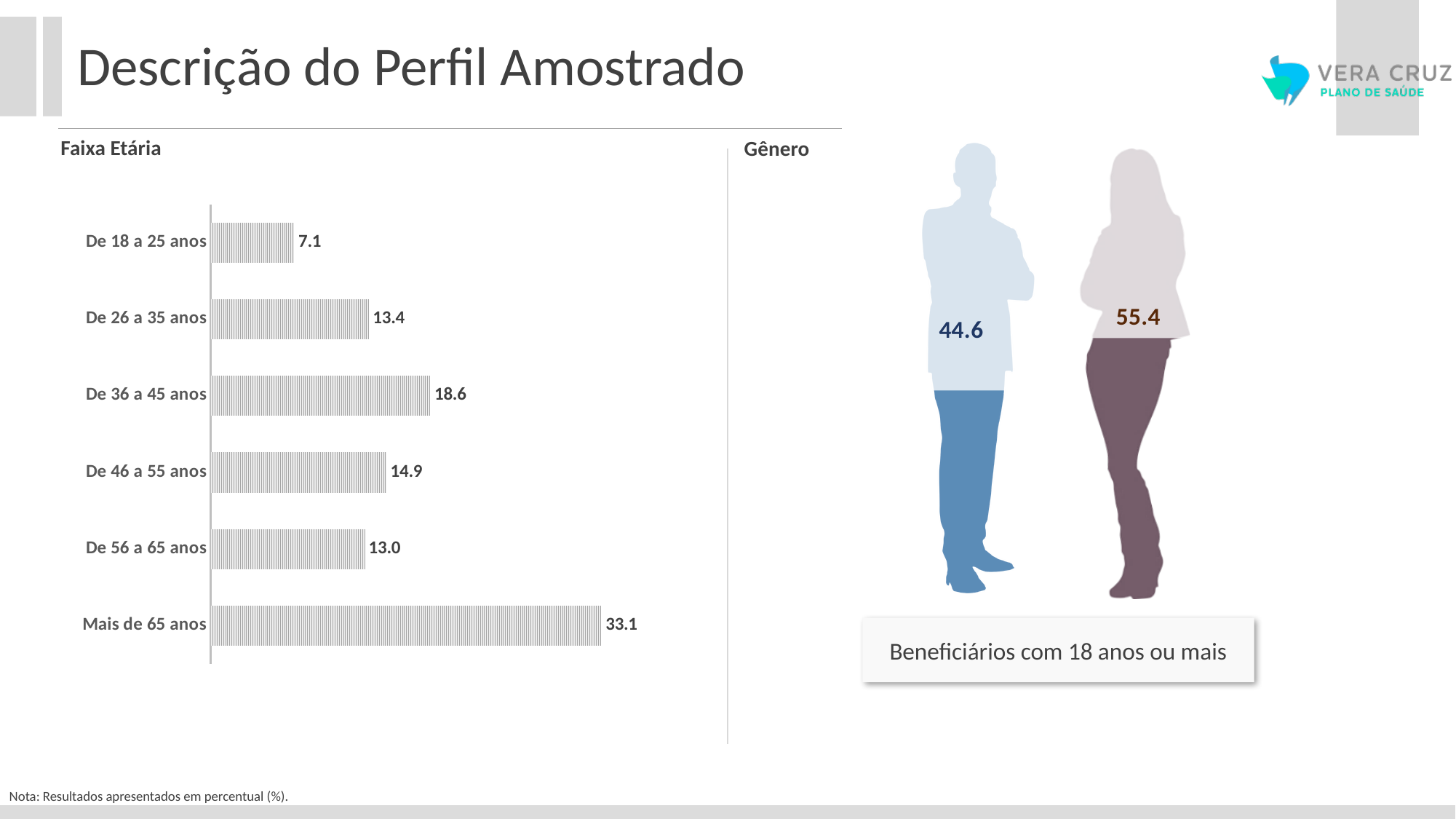
In the Faixa Etária chart, what is the value for De 36 a 45 anos? 18.6 How many age groups are shown in the Faixa Etária chart? 6 In the Faixa Etária chart, what is the value for De 18 a 25 anos? 7.1 In the Faixa Etária chart, which age group has the lowest value? De 18 a 25 anos In the Faixa Etária chart, which is larger: De 46 a 55 anos or De 56 a 65 anos? De 46 a 55 anos In the Faixa Etária chart, what is the value for De 56 a 65 anos? 13.0 In the Faixa Etária chart, which age group has the highest value? Mais de 65 anos In the Faixa Etária chart, what is the difference between Mais de 65 anos and De 36 a 45 anos? 14.5 What type of chart is the Faixa Etária chart? Bar chart According to the note at the bottom of the slide, in what unit are the results presented? Percentual (%) In the Faixa Etária chart, what is the difference between De 46 a 55 anos and De 26 a 35 anos? 1.5 In the Gênero section, what is the value shown for the female figure? 55.4